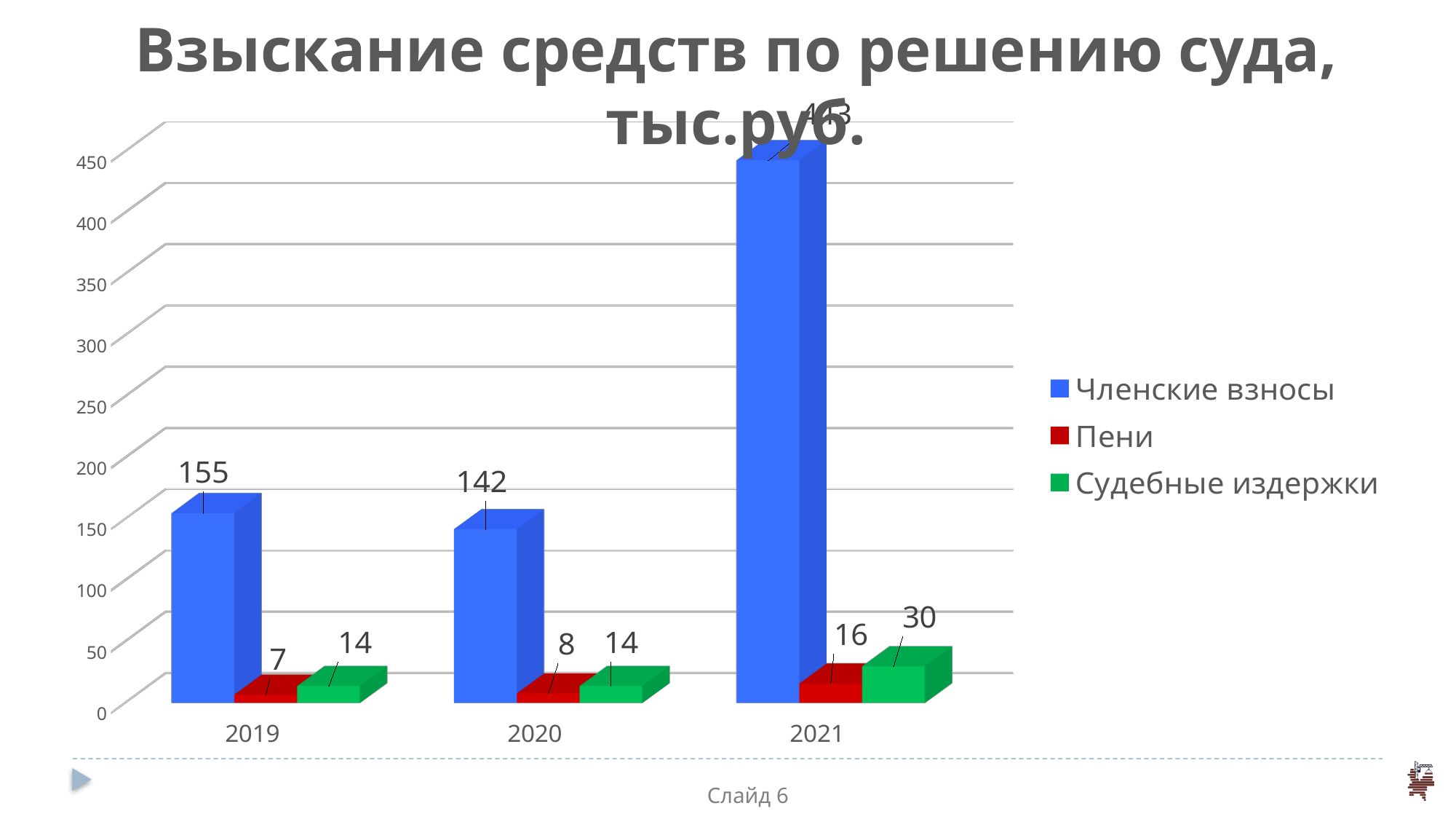
Is the value for Членские взносы in 2021 greater or less than 400? greater What is the value for Членские взносы in 2019? 155 In 2021, which is larger: Пени or Судебные издержки? Судебные издержки How many years are shown on the x axis? 3 What is the value for Пени in 2020? 8 Do the values for Пени rise or fall from 2019 to 2021? rise In which year is the value for Судебные издержки the highest? 2021 What is the difference between the Членские взносы values for 2019 and 2020? 13 What is the value for Судебные издержки in 2021? 30 How many series does the legend list? 3 In which year is the value for Пени the lowest? 2019 What kind of chart is shown on the slide? bar chart